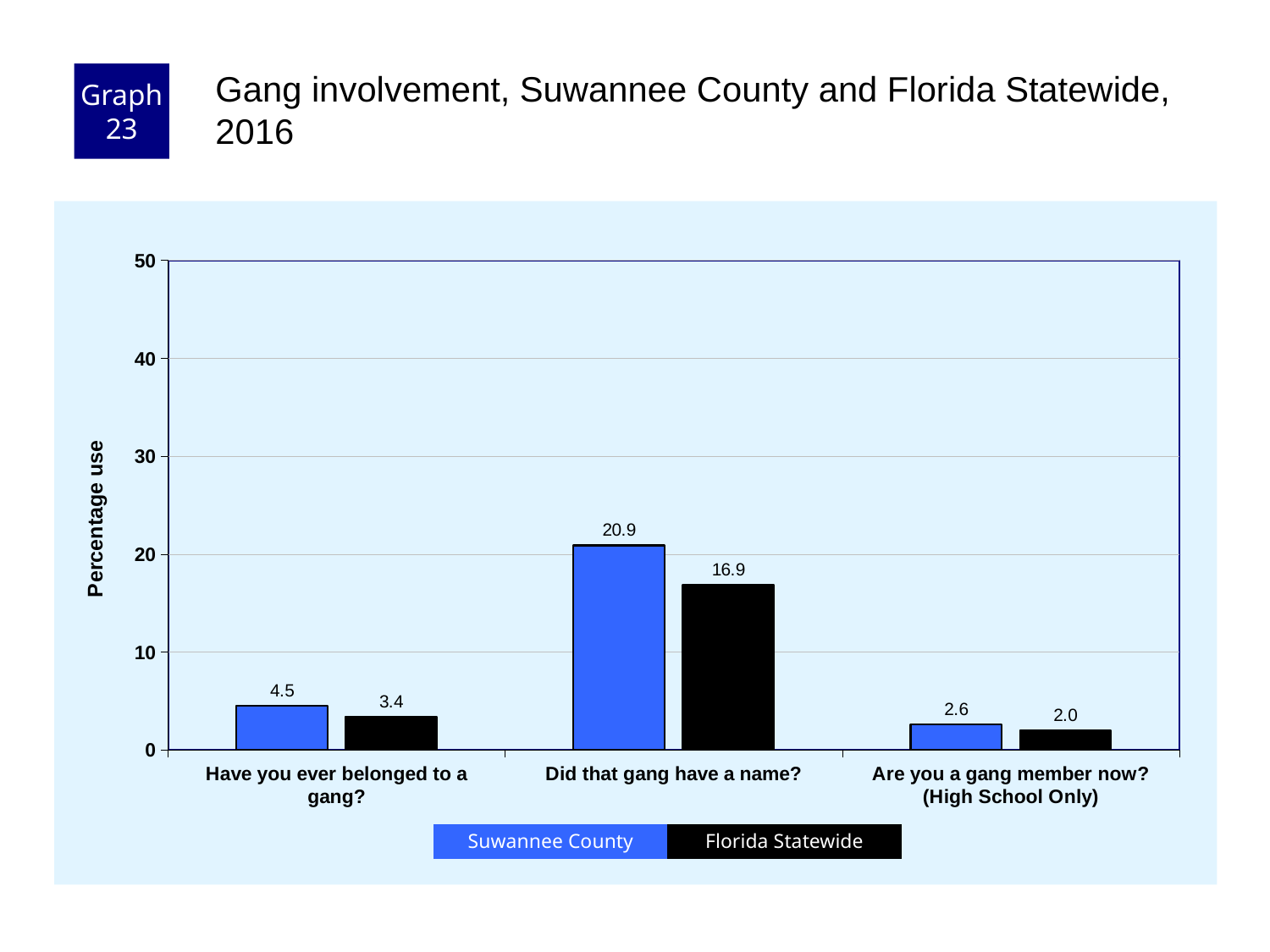
What is the Suwannee County value for "Are you a gang member now? (High School Only)"? 2.6 What is the label on the y axis? Percentage use How many series does the legend list? 2 Which question has the highest Florida Statewide value? Did that gang have a name? Which question has the lowest Suwannee County value? Are you a gang member now? (High School Only) How many questions (categories) are shown on the x axis? 3 For "Have you ever belonged to a gang?", which is larger: Suwannee County or Florida Statewide? Suwannee County What is the Suwannee County value for "Did that gang have a name?"? 20.9 What is the Florida Statewide value for "Have you ever belonged to a gang?"? 3.4 Is the Suwannee County value for "Did that gang have a name?" greater or less than 20? greater What is the difference between the Suwannee County and Florida Statewide values for "Did that gang have a name?"? 4.0 What kind of chart is shown on the slide? Bar chart